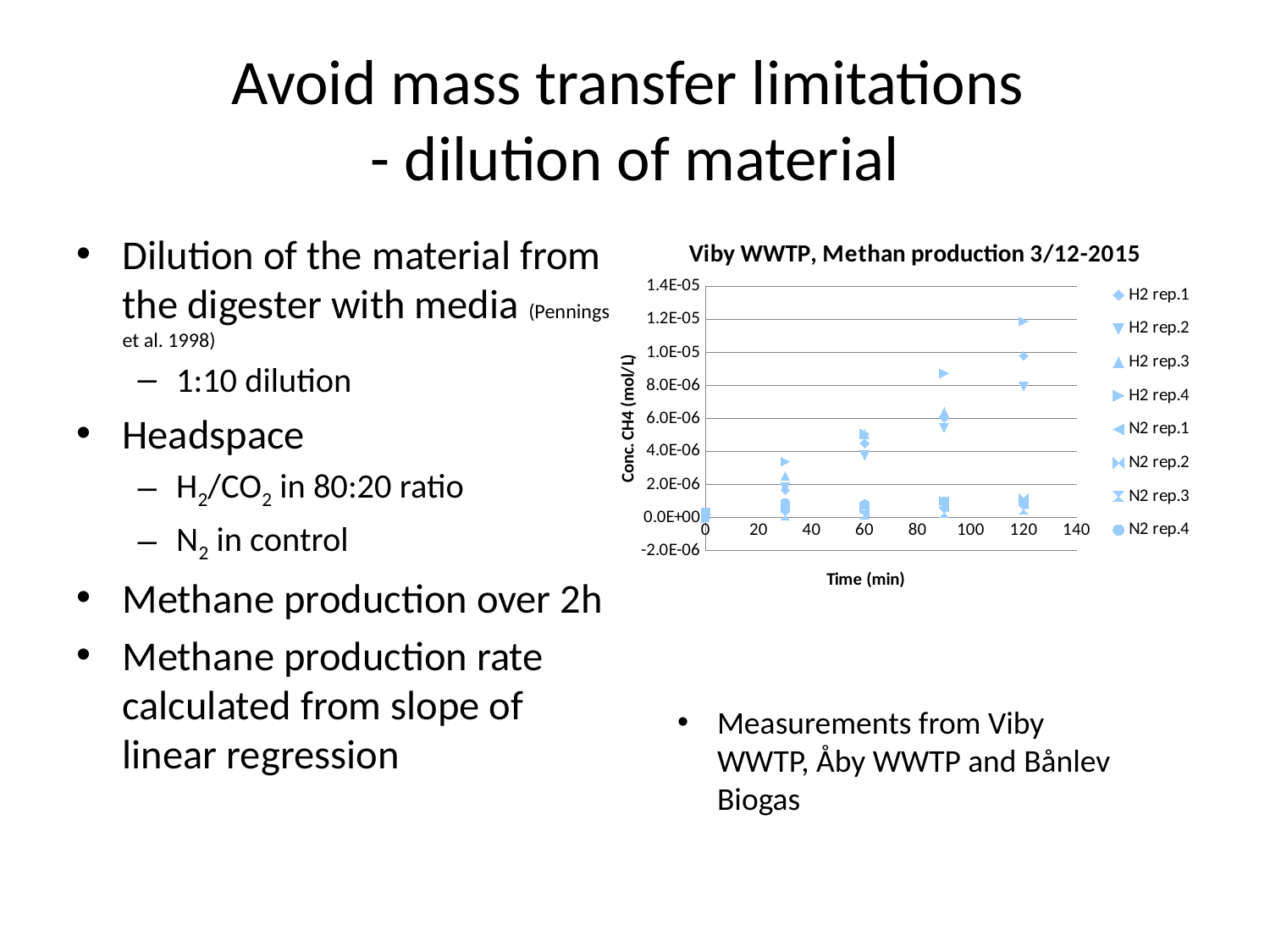
Do the values for H2 rep.4 rise or fall as time increases? rise What is the label of the y axis of the chart? Conc. CH4 (mol/L) Are the values for the N2 series at 120 min greater or less than 2.0E-06? less What kind of chart is shown on the slide? scatter chart Is the value for H2 rep.4 at 90 min greater or less than 8.0E-06? greater Is the value for H2 rep.4 at 30 min greater or less than 2.0E-06? greater Which series reaches the highest value at 120 min? H2 rep.4 How many time points are plotted for each series? 5 What is the title of the chart? Viby WWTP, Methan production 3/12-2015 At 120 min, which is larger: the value for H2 rep.4 or the value for N2 rep.4? H2 rep.4 How many series does the chart legend list? 8